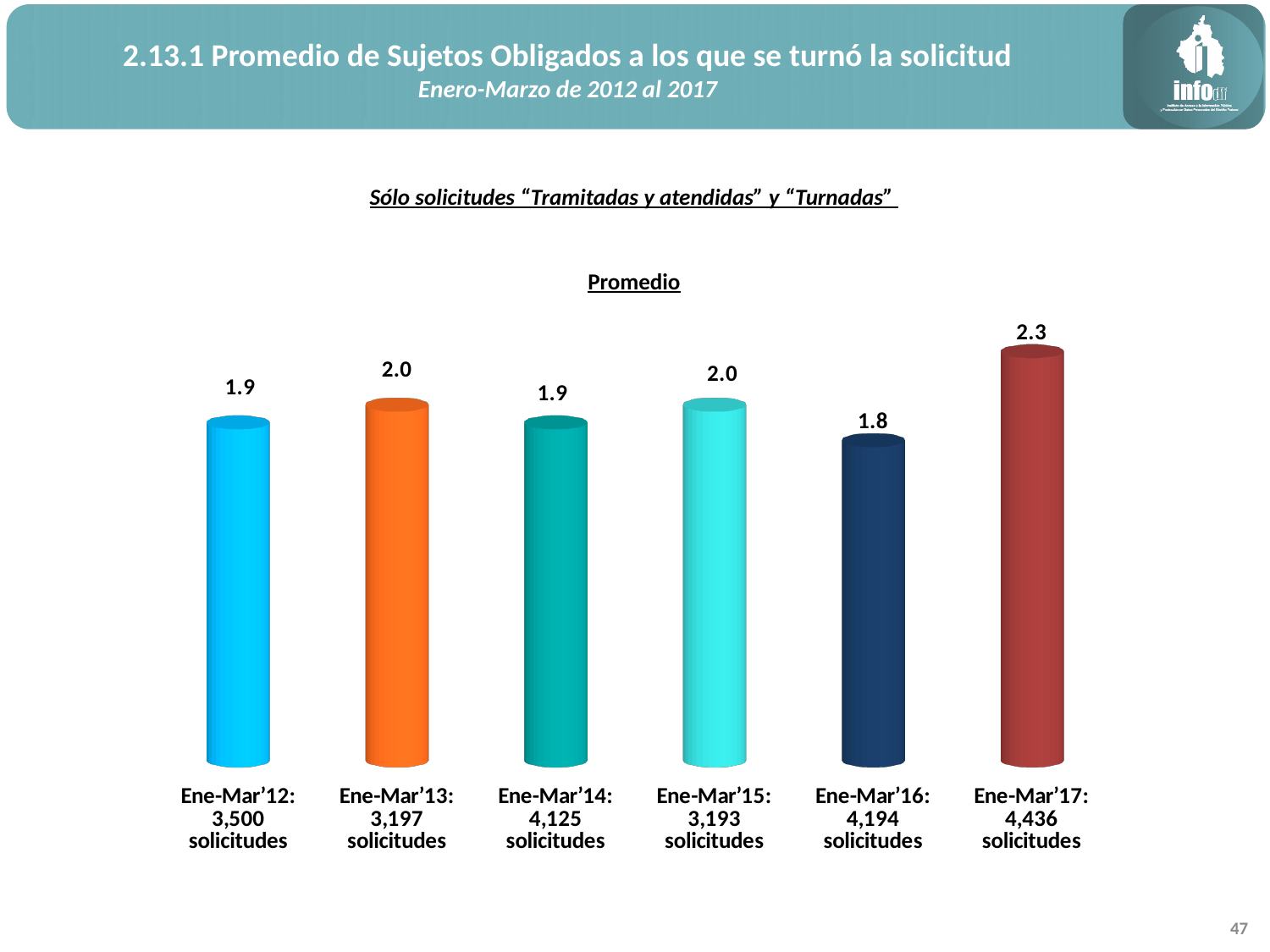
How many solicitudes are listed under the Ene-Mar'14 label? 4,125 What is the value for Ene-Mar'16? 1.8 How many periods are shown in the chart? 6 What is the value for Ene-Mar'12? 1.9 Which period has the highest value? Ene-Mar'17 What is the difference between the values for Ene-Mar'17 and Ene-Mar'16? 0.5 Which is larger, the value for Ene-Mar'17 or the value for Ene-Mar'13? Ene-Mar'17 What is the value for Ene-Mar'17? 2.3 What is the value for Ene-Mar'15? 2.0 Which period has the lowest value? Ene-Mar'16 What kind of chart is shown on the slide? Bar chart What is the difference between the values for Ene-Mar'13 and Ene-Mar'12? 0.1